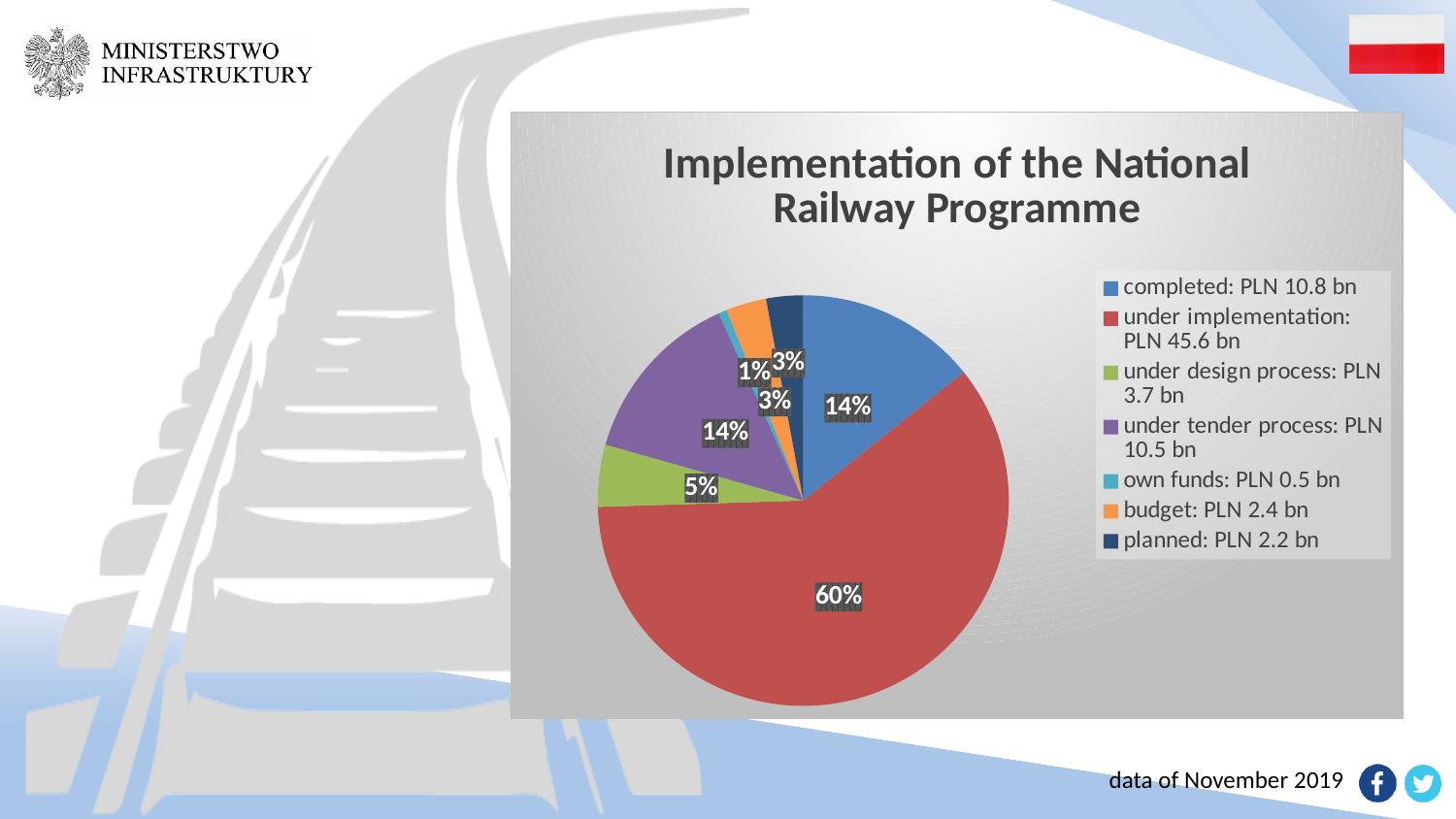
Which category has the largest slice of the pie? under implementation Which slice is larger: 'under design process' or 'budget'? under design process What share of the pie is labelled for 'under design process'? 5% What share of the pie is labelled for 'under implementation'? 60% What share of the pie is labelled for 'completed'? 14% Which category has the smallest slice of the pie? own funds How many slices does the pie chart have? 7 According to the legend, what amount is given for 'under tender process'? PLN 10.5 bn What is the title of the chart? Implementation of the National Railway Programme What kind of chart is shown on the slide? pie chart What is the difference in percentage points between the 'under implementation' slice and the 'completed' slice? 46